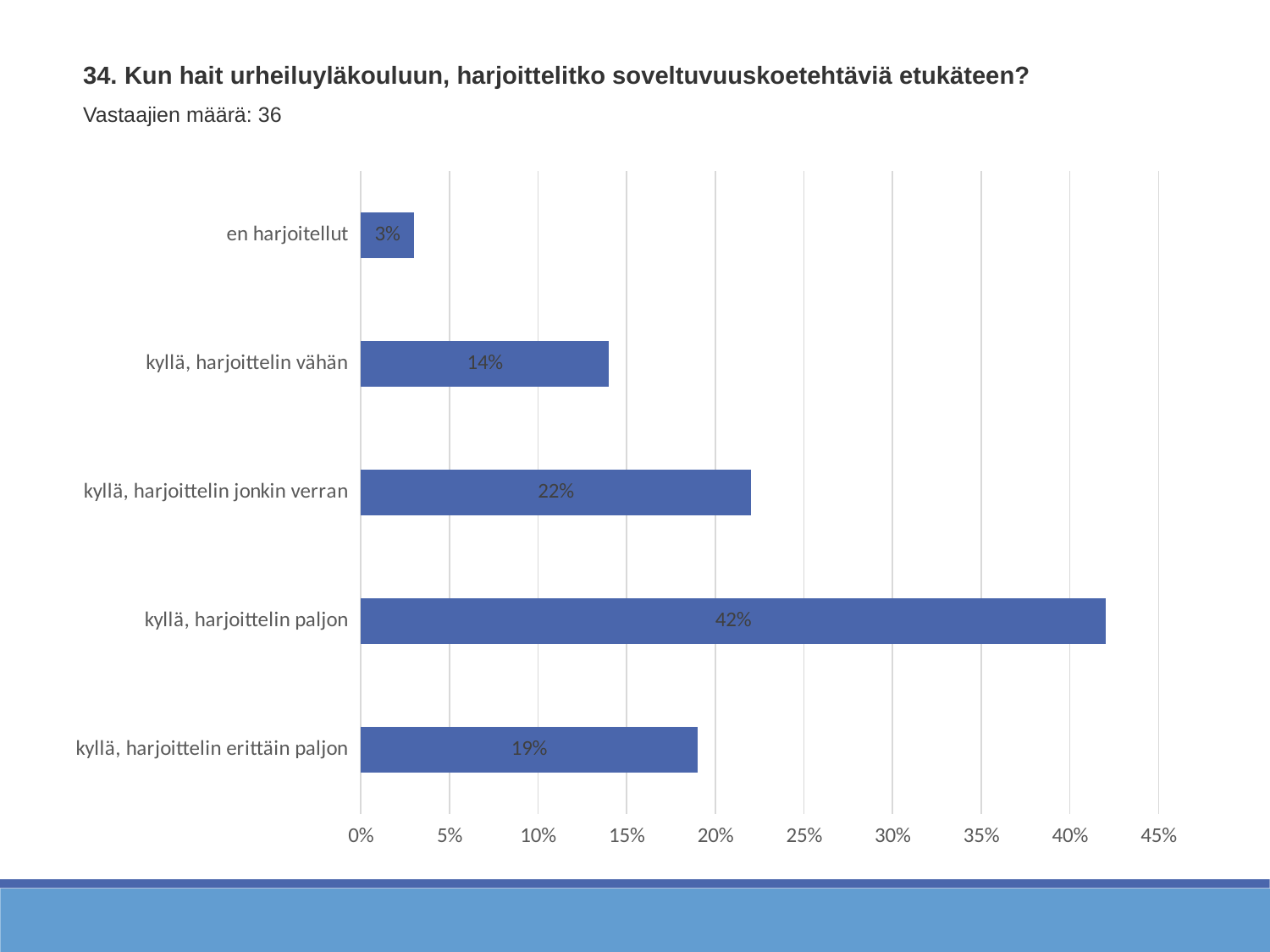
What is the difference between the values for "kyllä, harjoittelin paljon" and "kyllä, harjoittelin jonkin verran"? 20% What is the value for "kyllä, harjoittelin erittäin paljon"? 19% Which category has the lowest value? en harjoitellut How many categories are shown in the chart? 5 What is the value for "kyllä, harjoittelin jonkin verran"? 22% Which is larger: the value for "kyllä, harjoittelin vähän" or "kyllä, harjoittelin erittäin paljon"? kyllä, harjoittelin erittäin paljon Which category has the highest value? kyllä, harjoittelin paljon What is the value for "kyllä, harjoittelin paljon"? 42% How many respondents (Vastaajien määrä) are stated on the slide? 36 What is the value for "en harjoitellut"? 3% What kind of chart is shown on the slide? bar chart Is the value for "kyllä, harjoittelin paljon" greater or less than 40%? greater